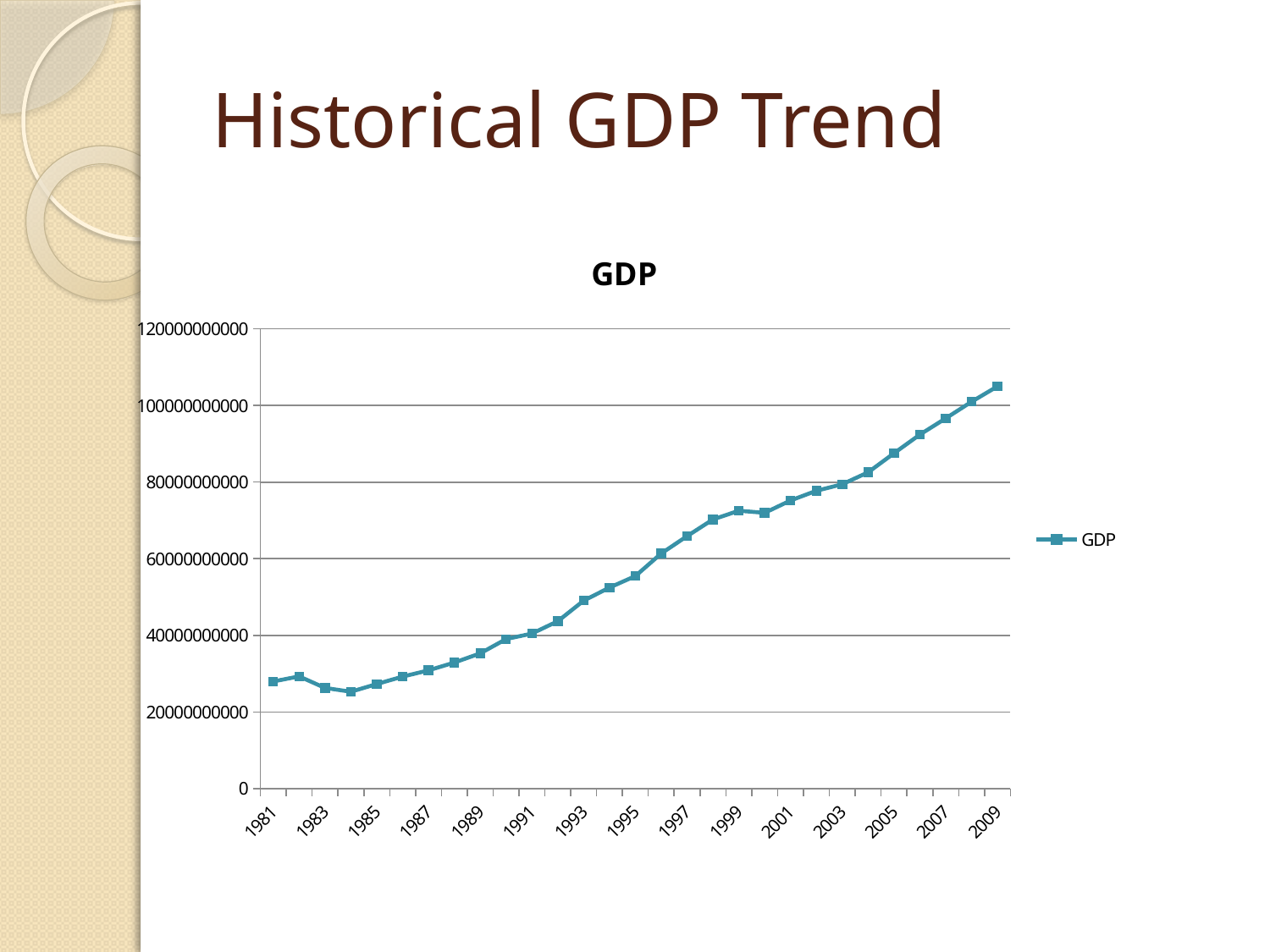
Is the GDP value for 1989 greater or less than 40000000000? less Is the GDP value for 2009 greater or less than 100000000000? greater Is the GDP value for 2005 greater or less than 80000000000? greater What is the title of the chart? GDP Which year has the larger GDP value, 1995 or 1997? 1997 What is the first year shown on the x axis? 1981 Does GDP generally rise or fall from 1981 to 2009? rise How many series does the legend list? 1 What kind of chart is shown on the slide? line chart Which year has the highest GDP value? 2009